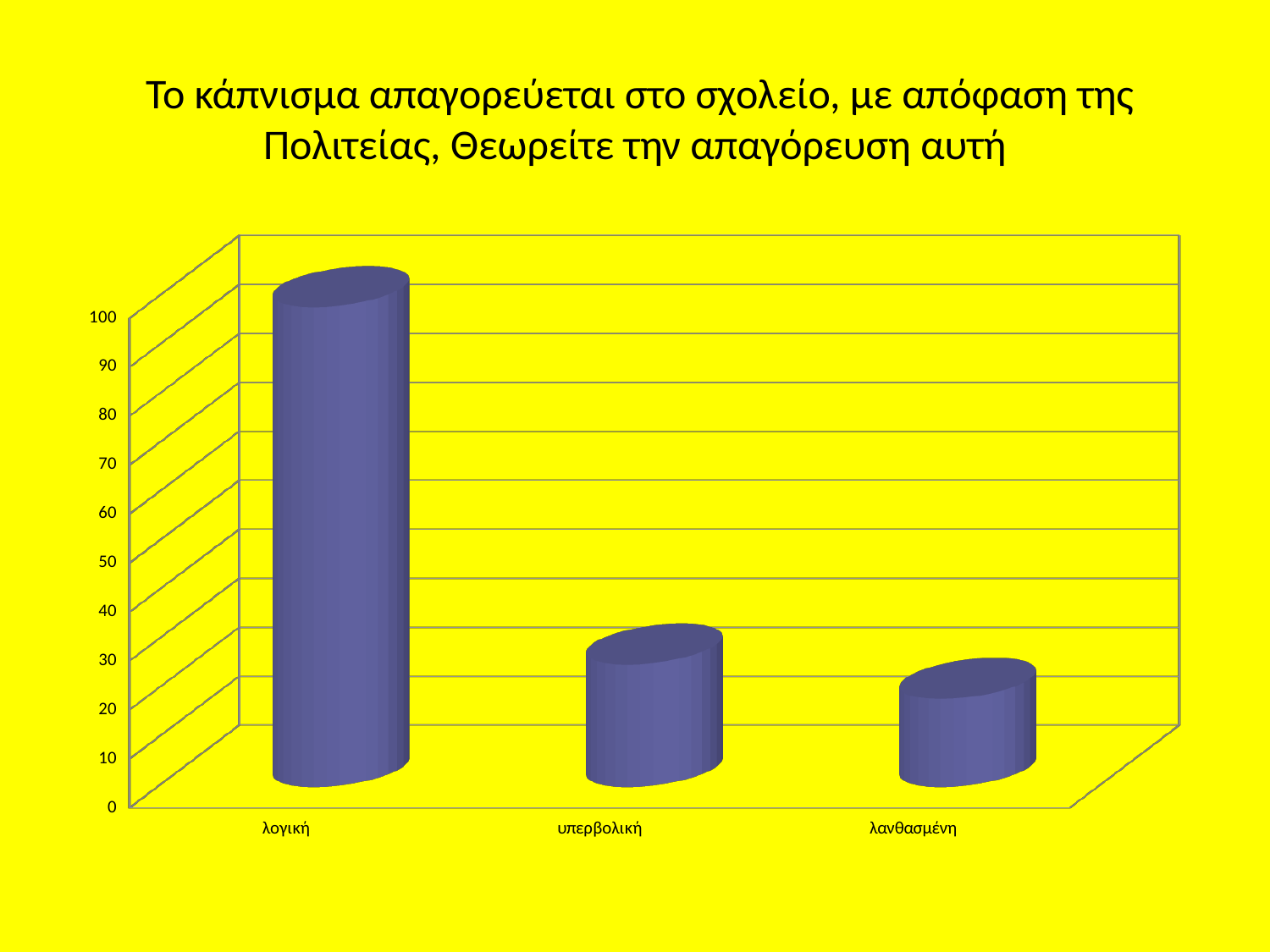
Which category has the highest value in the chart? λογική Which is larger, the value for υπερβολική or the value for λανθασμένη? υπερβολική Is the value for υπερβολική greater or less than 50? less Do the values rise or fall from left to right along the x axis? fall Is the value for λογική greater or less than 60? greater Is the value for λανθασμένη greater or less than 40? less What kind of chart is shown on the slide? bar chart Which category has the lowest value in the chart? λανθασμένη How many categories are shown on the x axis of the chart? 3 What colour are the bars in the chart? blue What is the highest tick value shown on the vertical axis of the chart? 100 Which is larger, the value for λογική or the value for υπερβολική? λογική